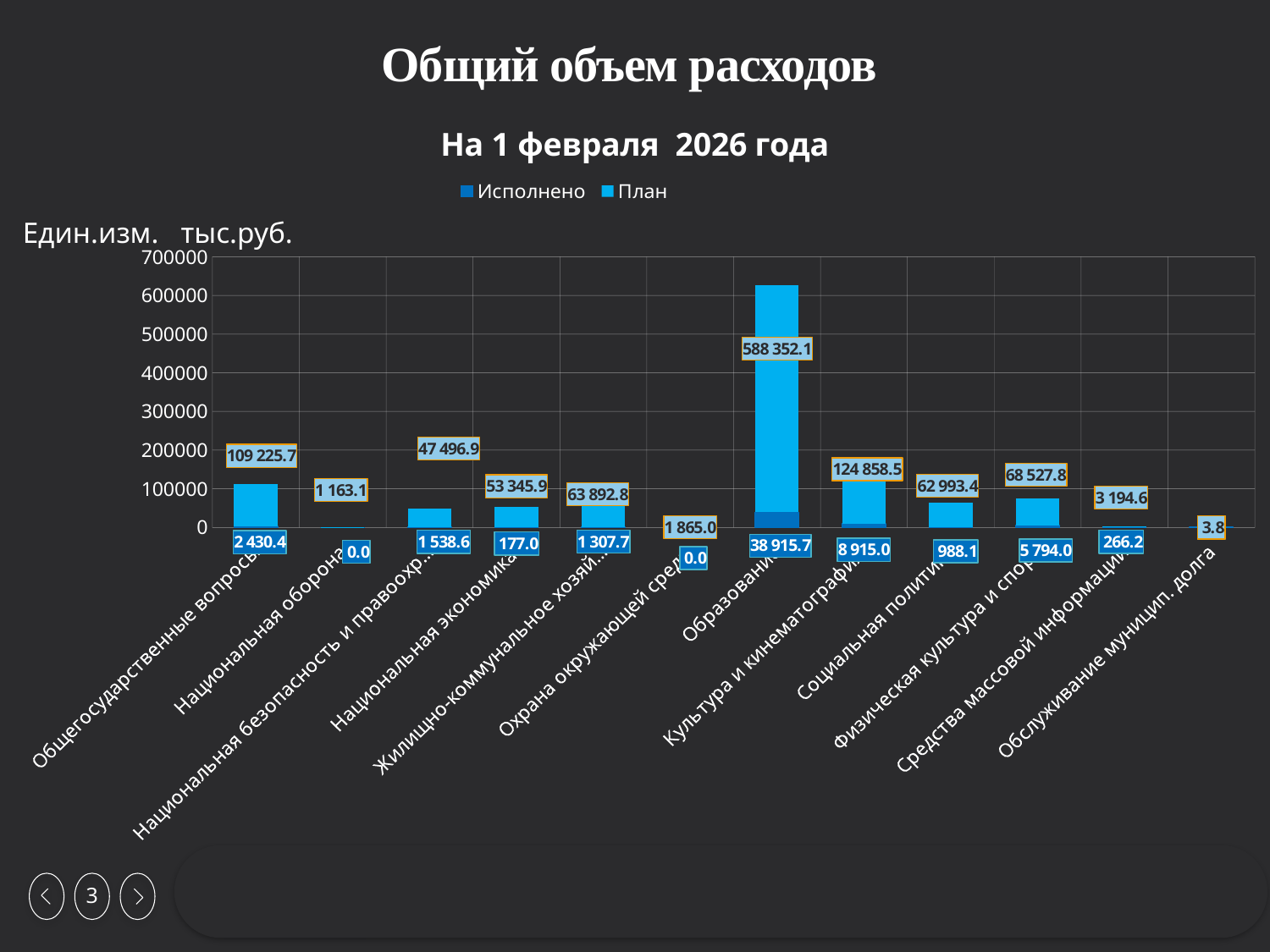
What is the Исполнено value for Физическая культура и спорт? 5 794.0 What kind of chart is shown on the slide? bar chart Which has the larger План value: Социальная политика or Физическая культура и спорт? Физическая культура и спорт How many categories are shown on the x axis? 12 Which category has the highest План value? Образование What is the Исполнено value for Национальная оборона? 0.0 What is the План value for Культура и кинематография? 124 858.5 Is the План value for Образование greater or less than 500000? greater What is the difference between the План and Исполнено values for Общегосударственные вопросы? 106 795.3 What is the Исполнено value for Образование? 38 915.7 What is the План value for Образование? 588 352.1 How many series does the legend list? 2